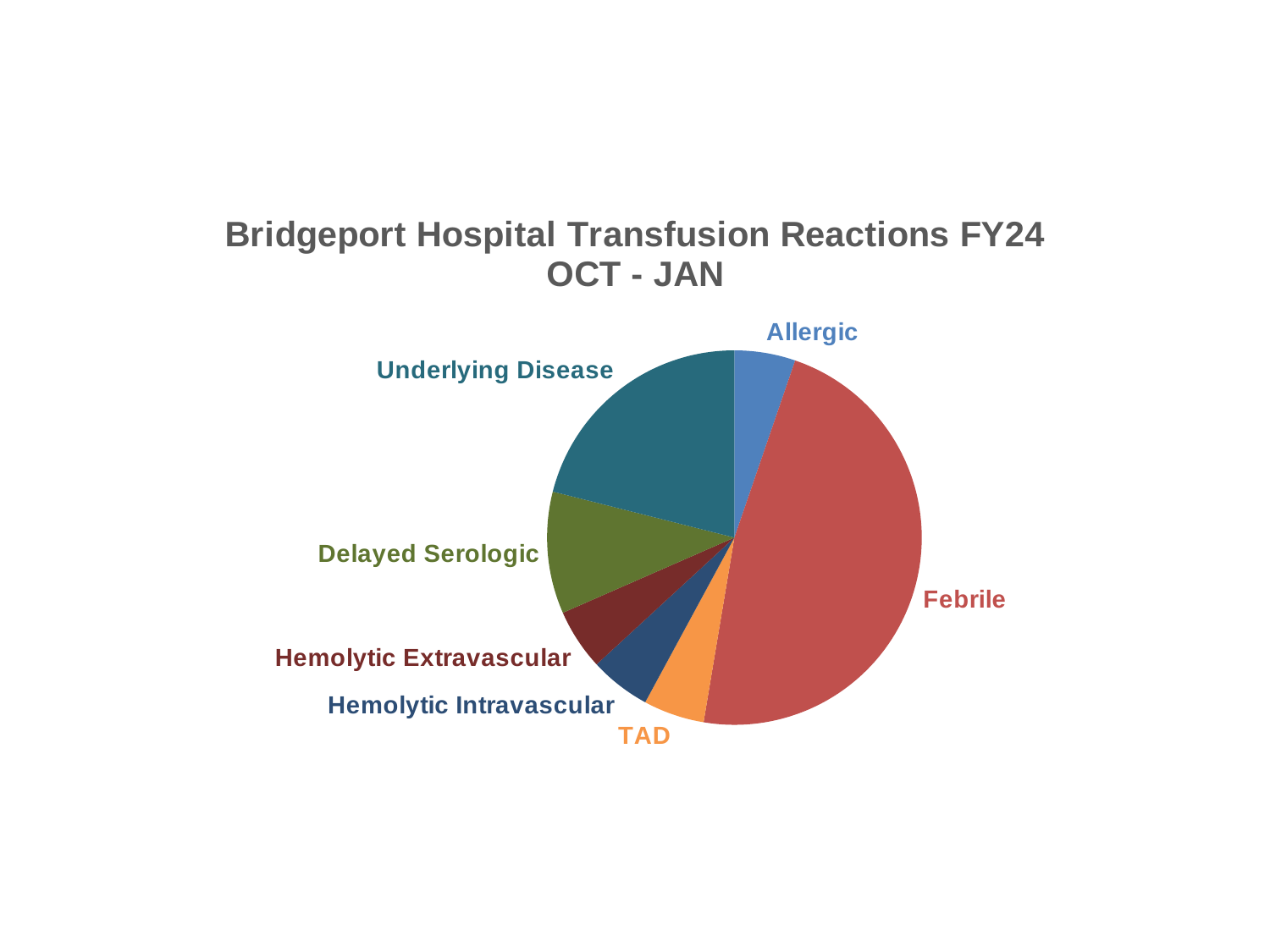
What kind of chart is shown on the slide? pie chart Which slice is larger, Febrile or Underlying Disease? Febrile What colour is the Febrile slice? red Which slice is larger, Underlying Disease or TAD? Underlying Disease Which slice is larger, Underlying Disease or Delayed Serologic? Underlying Disease How many categories (slices) does the pie chart have? 7 Which category has the largest slice of the pie? Febrile Which category has the second-largest slice of the pie? Underlying Disease What is the title of the chart? Bridgeport Hospital Transfusion Reactions FY24 OCT - JAN